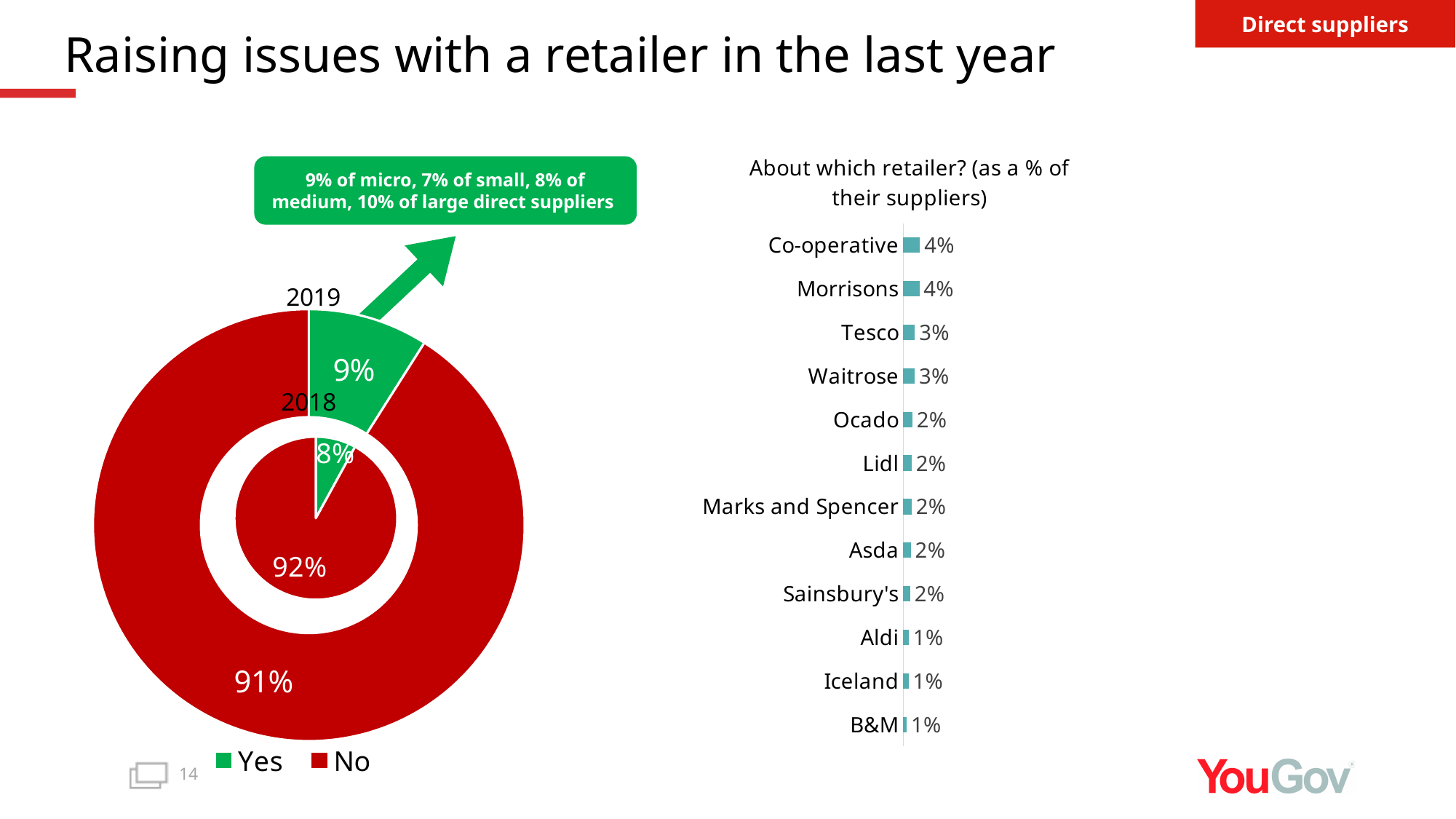
What type of chart is the 'About which retailer?' chart on the right? Bar chart In the 'About which retailer?' chart, what is the value for Sainsbury's? 2% In the 'About which retailer?' chart, which retailers share the highest value? Co-operative and Morrisons In the doughnut chart on the left, by how many percentage points did the Yes share change from 2018 to 2019? 1 percentage point In the doughnut chart on the left, which colour represents the No responses? Red In the 'About which retailer?' chart, what is the value for Tesco? 3% In the 'About which retailer?' chart, what is the difference between the values for Co-operative and Aldi? 3 percentage points In the doughnut chart on the left, how many entries does the legend list? 2 In the doughnut chart on the left, what percentage answered No in 2019? 91% In the doughnut chart on the left, what percentage answered No in 2018? 92% In the doughnut chart on the left, what percentage of direct suppliers answered Yes in 2019? 9% In the 'About which retailer?' chart, how many retailers are listed? 12